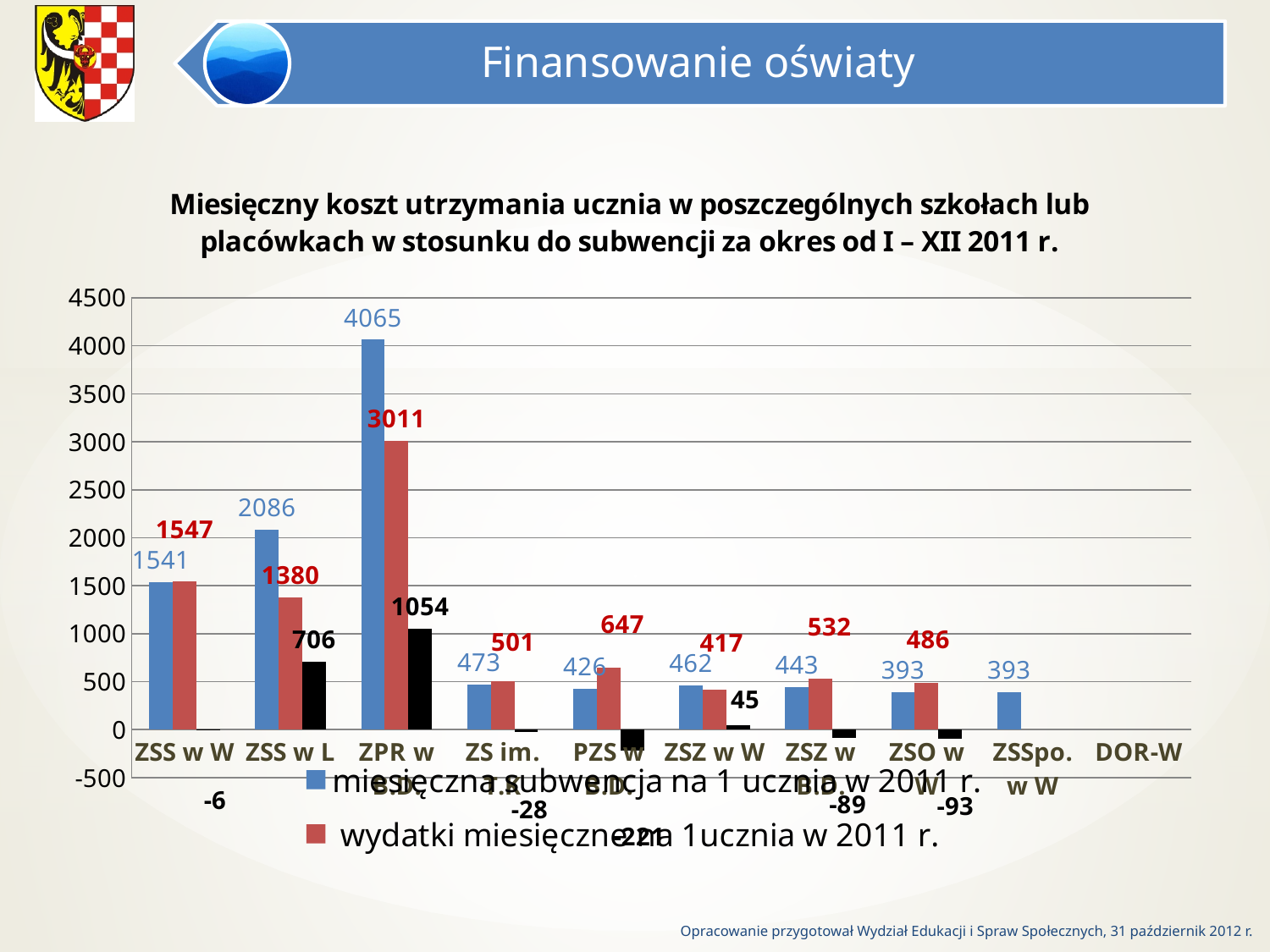
How many schools or institutions are listed on the x axis of the chart? 10 What is the monthly subsidy per pupil for ZSSpo. w W? 393 What kind of chart is shown on the slide? bar chart What period does the chart title say the data covers? I – XII 2011 r. What is the difference between the monthly subsidy (4065) and the monthly expenses (3011) for ZPR w B.D.? 1054 What are the monthly expenses per pupil (wydatki miesięczne na 1 ucznia) for ZSS w L? 1380 Which school has the highest monthly subsidy per pupil? ZPR w B.D. For ZSS w W, which is larger: the monthly subsidy per pupil or the monthly expenses per pupil? monthly expenses (1547) What is the monthly subsidy per pupil (miesięczna subwencja na 1 ucznia) for ZSS w W? 1541 Is the monthly subsidy per pupil for ZSS w W greater or less than 1500? greater What are the monthly expenses per pupil for ZSZ w W? 417 What is the difference between the monthly subsidy and the monthly expenses per pupil for ZSS w L? 706